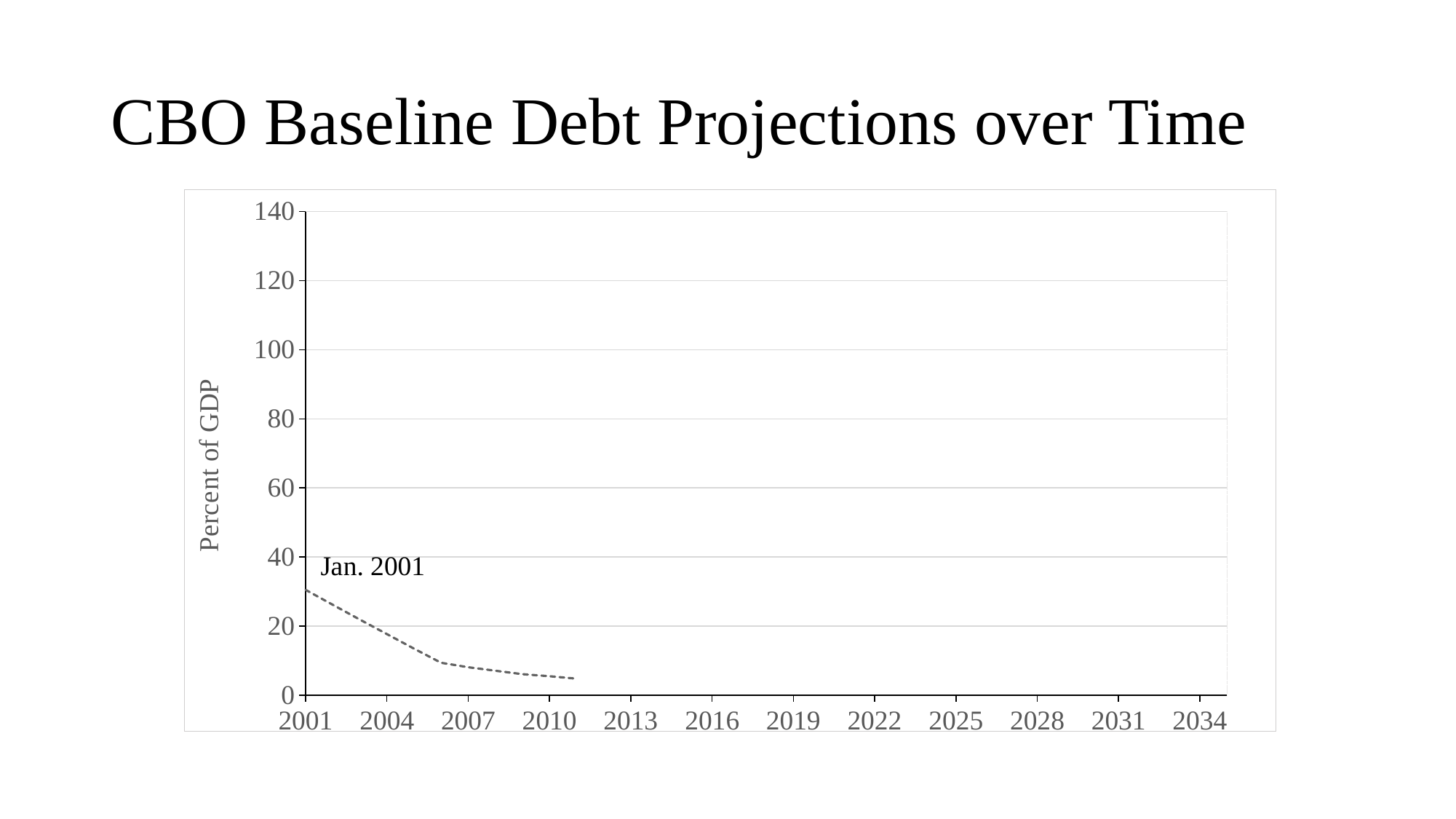
What is the highest value shown on the vertical axis? 140 Is the value of the dashed line at 2001 greater or less than 20? greater Is the value of the dashed line at 2001 greater or less than 40? less What is the title of the chart? CBO Baseline Debt Projections over Time Is the value of the dashed line at 2010 greater or less than 20? less What is the label on the vertical axis of the chart? Percent of GDP Which year has the higher value on the dashed line, 2001 or 2010? 2001 Which year has the lower value on the dashed line, 2004 or 2007? 2007 What kind of chart is shown on the slide? line chart Does the dashed line rise or fall as the years increase from 2001 to 2010? fall